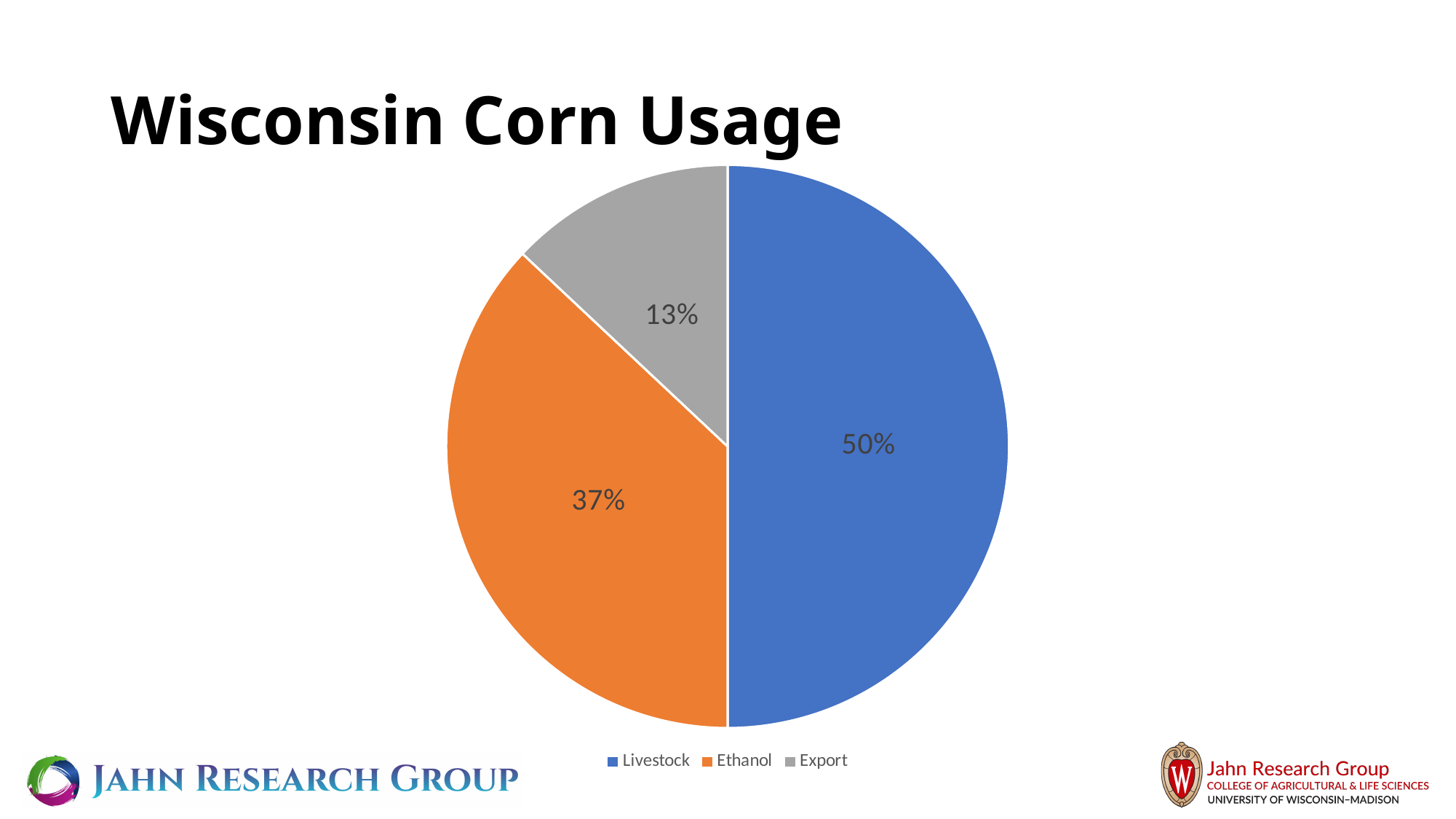
What share of Wisconsin corn usage goes to Livestock? 50% What is the difference in percentage points between the Ethanol and Export shares? 24 Which category has the largest share of Wisconsin corn usage? Livestock What is the difference in percentage points between the Livestock and Ethanol shares? 13 What share of Wisconsin corn usage goes to Ethanol? 37% Which has a larger share, Ethanol or Export? Ethanol What share of Wisconsin corn usage goes to Export? 13% Which category has the smallest share of Wisconsin corn usage? Export What colour is the Ethanol slice? Orange How many categories are shown in the pie chart? 3 What is the title of the chart? Wisconsin Corn Usage What kind of chart is shown on the slide? Pie chart